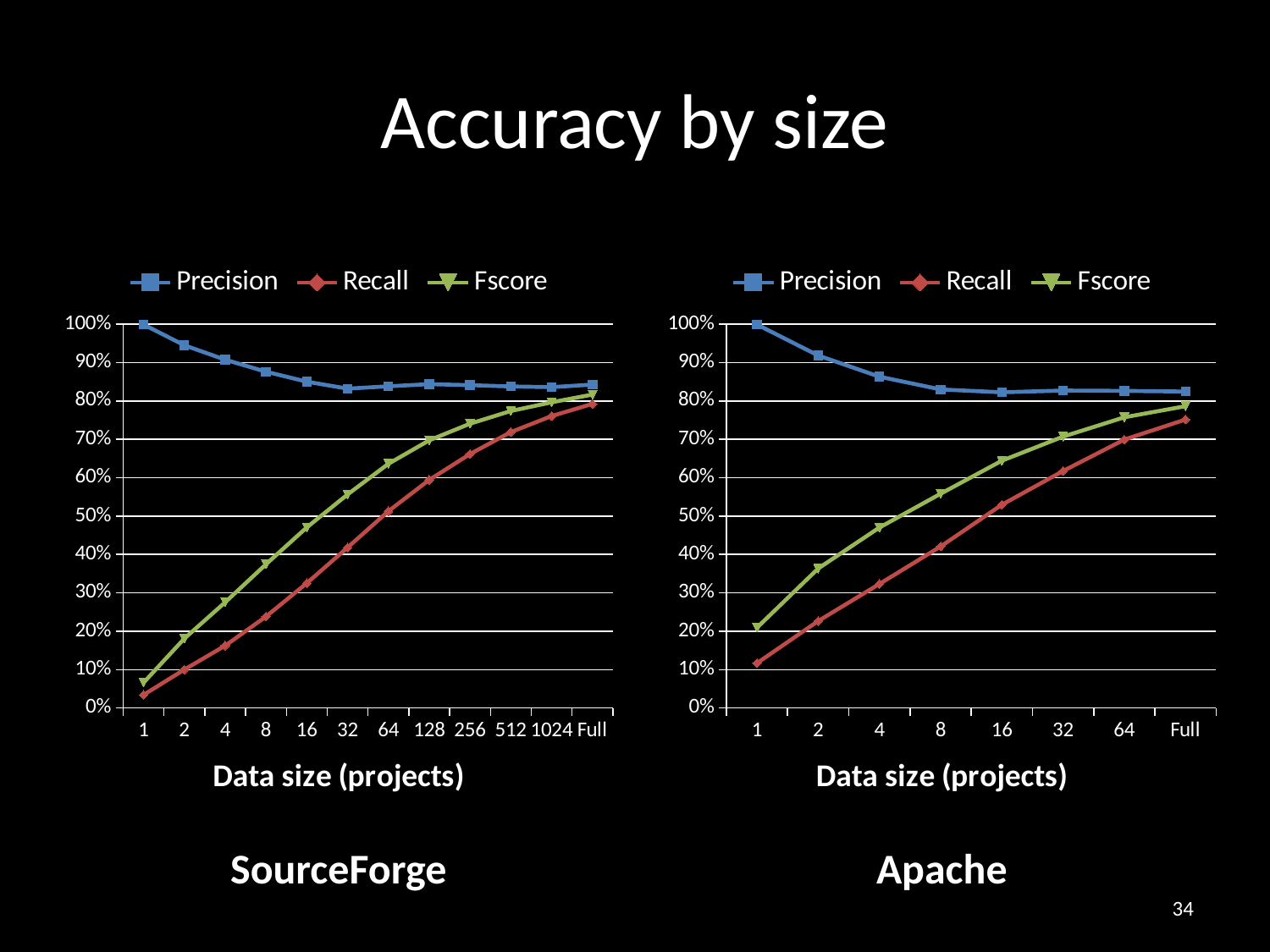
What type of chart is the SourceForge chart? line chart In the Apache chart, does the Recall series rise or fall as data size increases? rise In the Apache chart, what is the Precision value at data size 1? 100% How many data size categories are shown on the x axis of the SourceForge chart? 12 In the Apache chart, is the Fscore value at data size 64 greater or less than 70%? greater In the SourceForge chart, what is the Precision value at data size 1? 100% In the Apache chart, which series has the highest value at data size 1? Precision In the SourceForge chart, is the Fscore value at data size 32 greater or less than 50%? greater How many data size categories are shown on the x axis of the Apache chart? 8 In the SourceForge chart, is the Recall value at data size 1 greater or less than 10%? less In the SourceForge chart, does the Precision series generally rise or fall as data size increases? fall How many series does the legend of the Apache chart list? 3